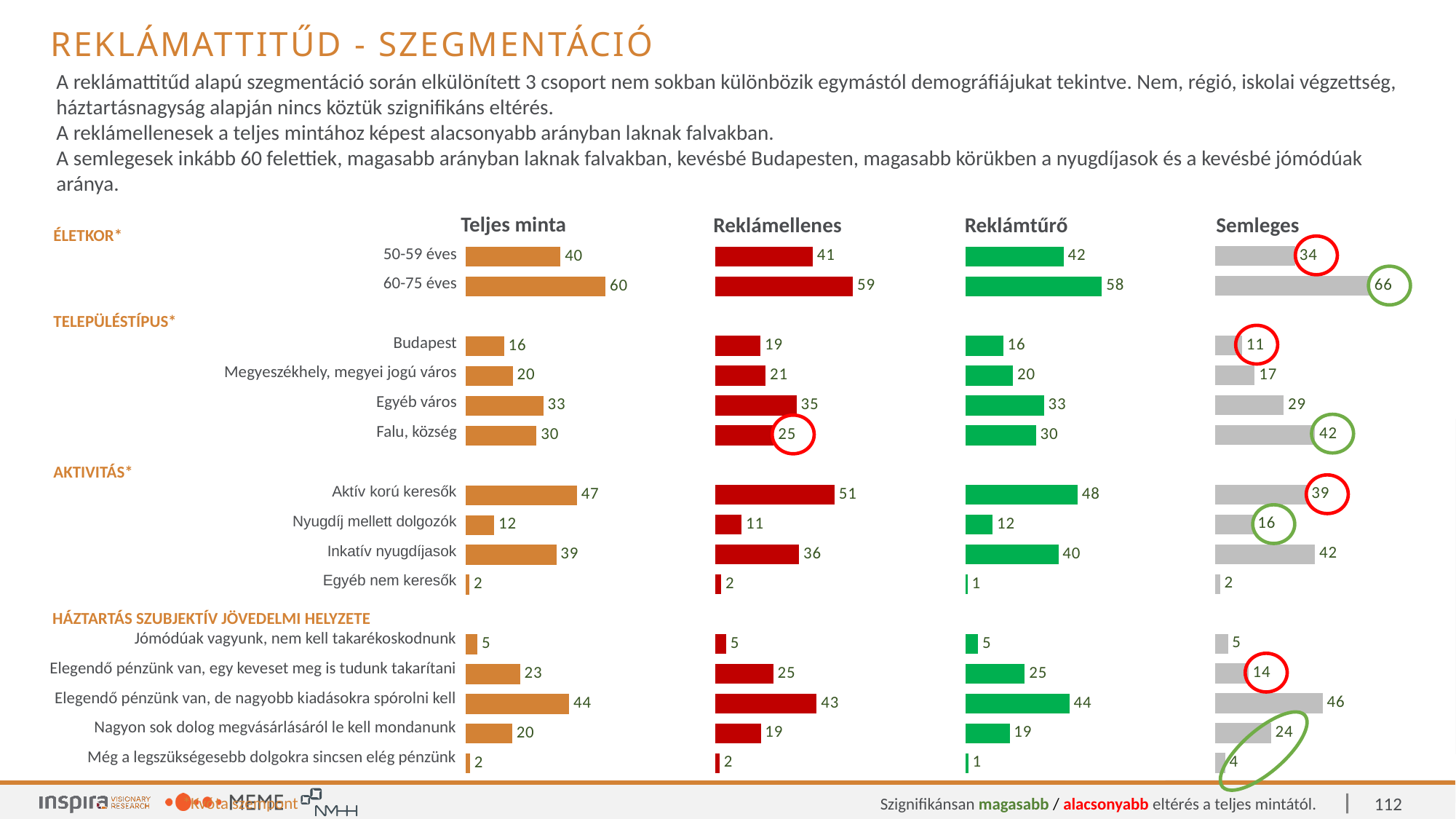
In the Semleges chart, what is the value for 60-75 éves? 66 Which is larger: the value for Budapest in the Reklámellenes chart or in the Semleges chart? Reklámellenes In the Reklámtűrő chart, what is the value for Inkatív nyugdíjasok? 40 In the Reklámellenes chart, which category under TELEPÜLÉSTÍPUS has the lowest value? Budapest In the Semleges chart, which category under TELEPÜLÉSTÍPUS has the highest value? Falu, község What colour are the bars in the Semleges chart? Grey In the Reklámellenes chart, what is the value for Falu, község? 25 How many categories are shown under HÁZTARTÁS SZUBJEKTÍV JÖVEDELMI HELYZETE in the Teljes minta chart? 5 What type of chart is used for the Reklámtűrő data? Bar chart In the Teljes minta chart, what is the difference between Egyéb város and Falu, község? 3 In the Teljes minta chart, what is the value for Aktív korú keresők? 47 In the Semleges chart, what is the difference between the values for 60-75 éves and 50-59 éves? 32